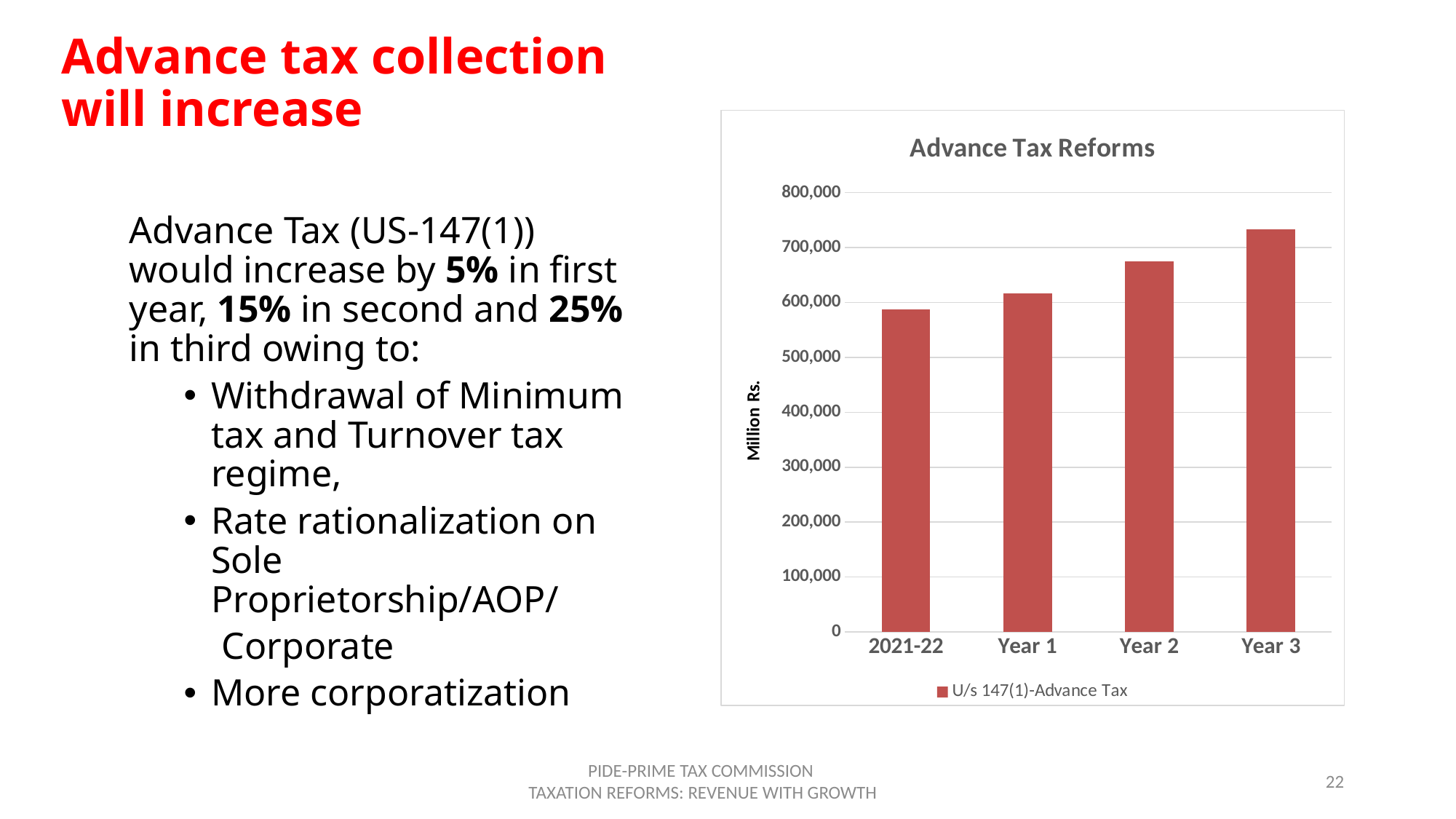
Which category has the highest value in the chart? Year 3 What type of chart is shown on the slide? bar chart Which category has the lowest value in the chart? 2021-22 Do the values rise or fall from 2021-22 to Year 3? rise Is the value for 2021-22 greater or less than 600,000? less How many categories are shown on the x axis of the chart? 4 What is the title of the chart? Advance Tax Reforms Is the value for Year 2 greater or less than 700,000? less Which is larger, the value for Year 1 or the value for Year 2? Year 2 Is the value for Year 3 greater or less than 700,000? greater How many series does the chart legend list? 1 What is the name of the series shown in the chart legend? U/s 147(1)-Advance Tax